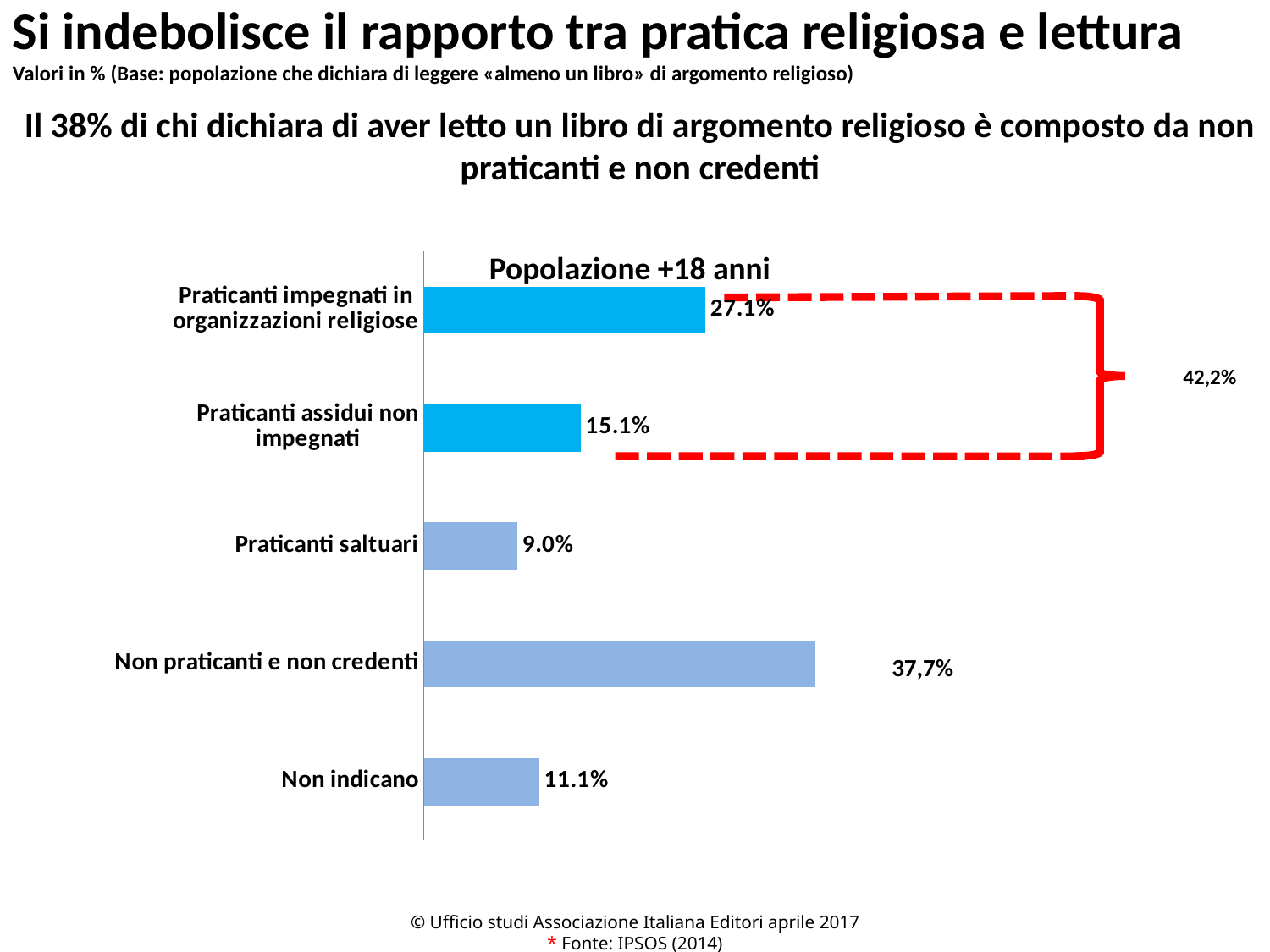
What is the title of the chart? Popolazione +18 anni What is the value for Non indicano? 11.1% What is the value for Praticanti saltuari? 9.0% How many categories are shown in the chart? 5 Which category has the highest value? Non praticanti e non credenti What kind of chart is shown on the slide? Bar chart Which category has the lowest value? Praticanti saltuari What is the value for Praticanti impegnati in organizzazioni religiose? 27.1% What is the value for Non praticanti e non credenti? 37,7% What is the value for Praticanti assidui non impegnati? 15.1% Which is larger, the value for Non indicano or the value for Praticanti saltuari? Non indicano What is the difference between the values for Praticanti impegnati in organizzazioni religiose and Praticanti assidui non impegnati? 12.0%